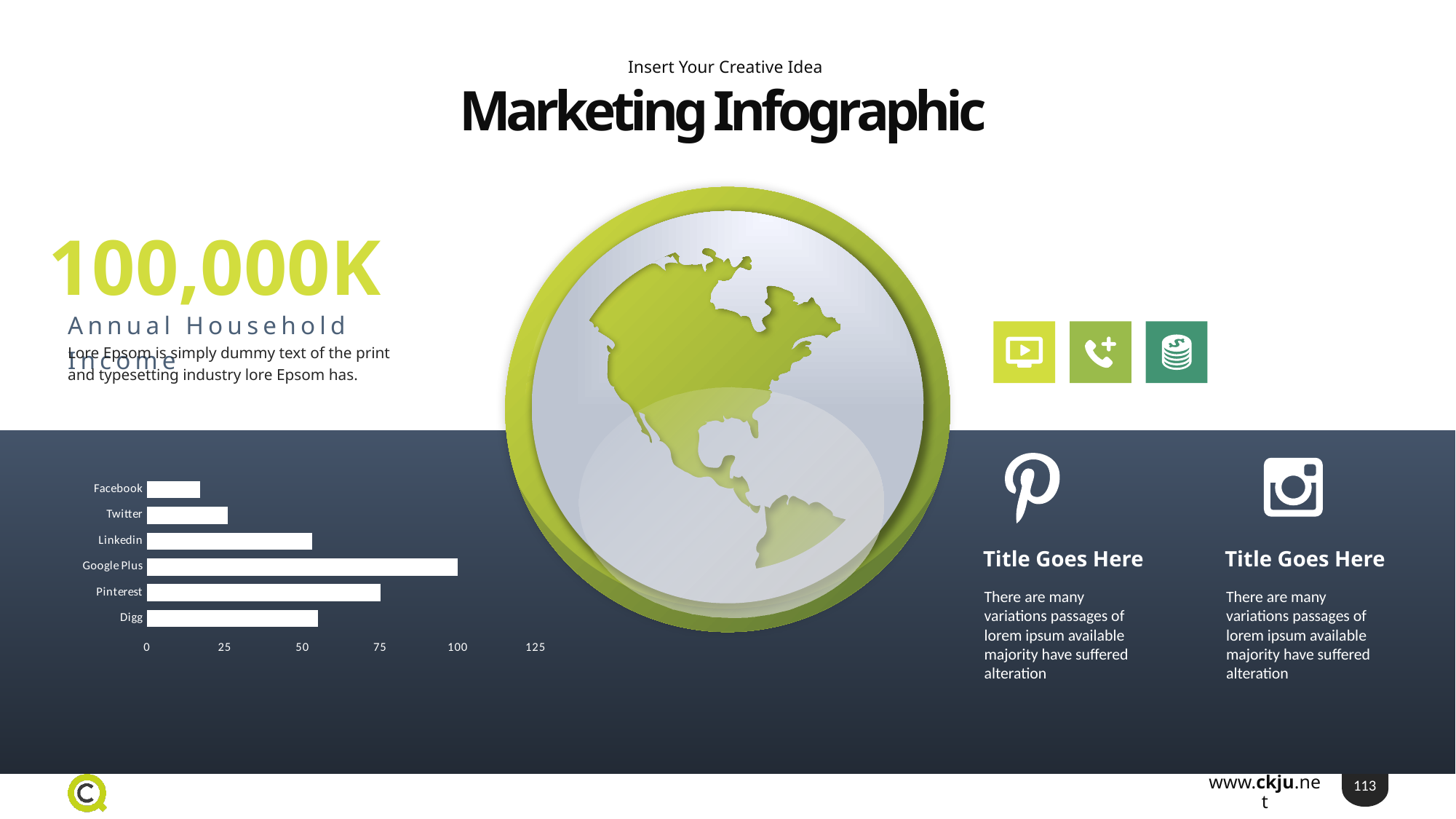
Which category has the shortest bar in the chart? Facebook Which category has the longest bar in the chart? Google Plus Is the value for Google Plus greater or less than 75? greater Is the value for Digg greater or less than 50? greater Is the value for Pinterest greater or less than 100? less What kind of chart is shown on the slide? bar chart Which has the larger value, Twitter or Facebook? Twitter What is the highest value shown on the chart's horizontal axis? 125 How many categories does the bar chart show? 6 Which has the larger value, Pinterest or Linkedin? Pinterest